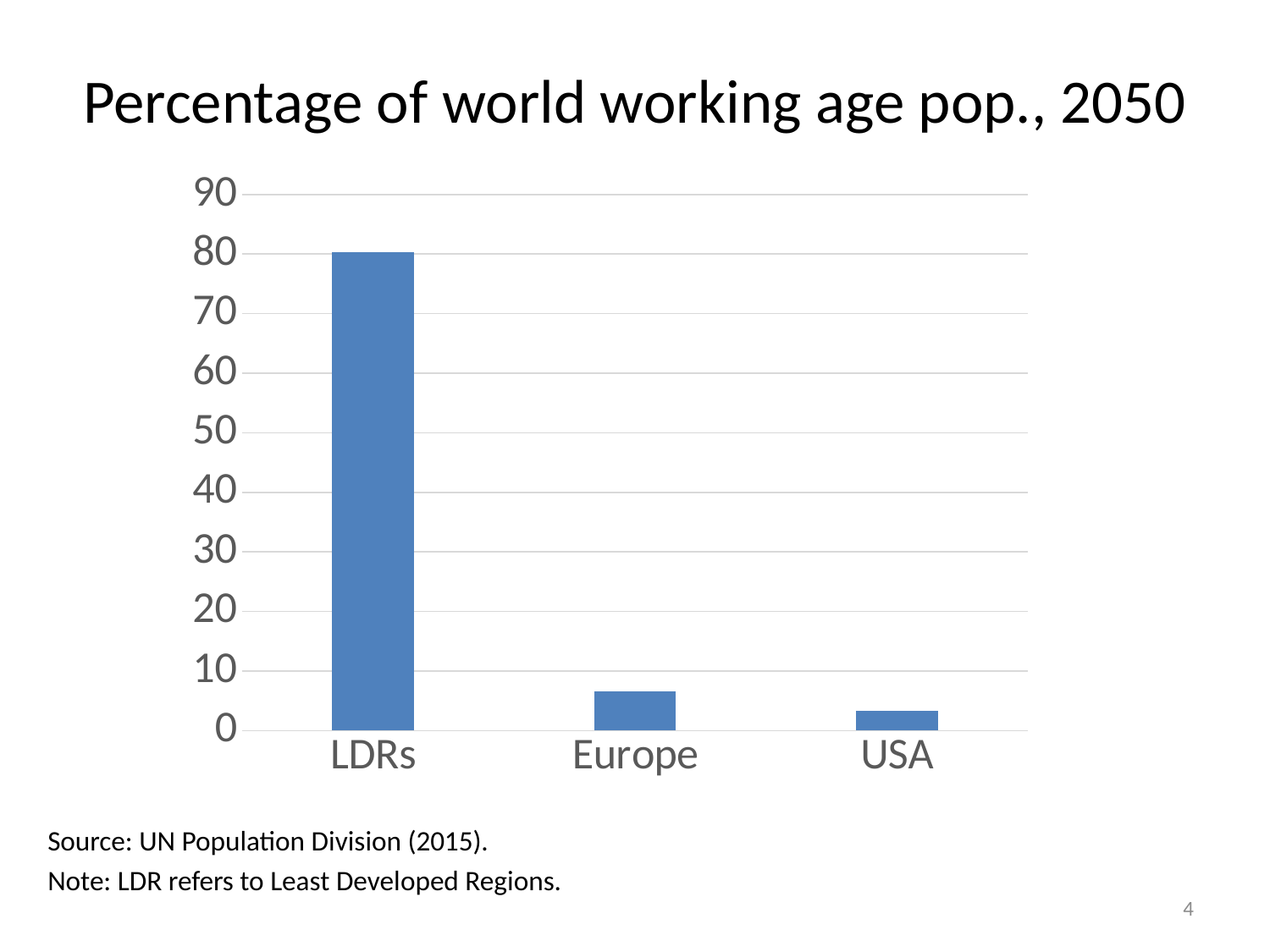
Is the value for Europe greater or less than 10? less Which has a larger value, LDRs or Europe? LDRs Is the value for USA greater or less than 10? less Which category has the lowest value in the chart? USA Is the value for LDRs greater or less than 90? less Which has a larger value, Europe or USA? Europe How many categories are shown on the x axis of the chart? 3 What is the highest value shown on the y axis of the chart? 90 Which category has the highest value in the chart? LDRs What is the title of the chart? Percentage of world working age pop., 2050 What kind of chart is shown on the slide? bar chart